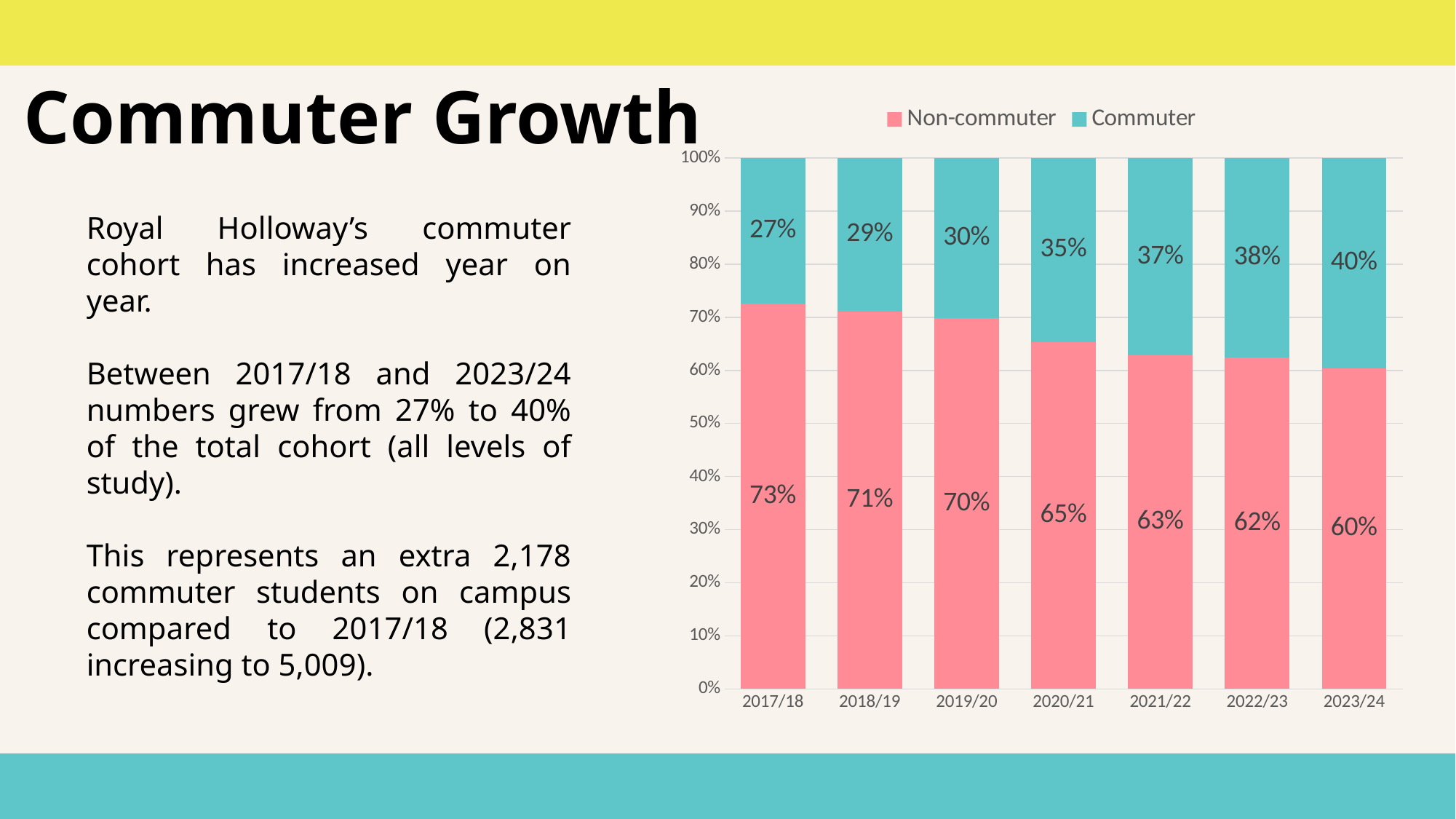
What is the Commuter value for 2020/21? 35% What kind of chart is shown? Stacked bar chart How many series does the legend list? 2 What is the Commuter value for 2017/18? 27% Which colour represents the Commuter series? Teal Which year has the lowest Non-commuter share? 2023/24 What is the difference between the Commuter values for 2023/24 and 2017/18? 13% Which is larger, the Non-commuter value for 2019/20 or for 2021/22? 2019/20 Does the Commuter share rise or fall from 2017/18 to 2023/24? Rise Which year has the highest Commuter share? 2023/24 How many years are shown on the x axis? 7 What is the Non-commuter value for 2023/24? 60%